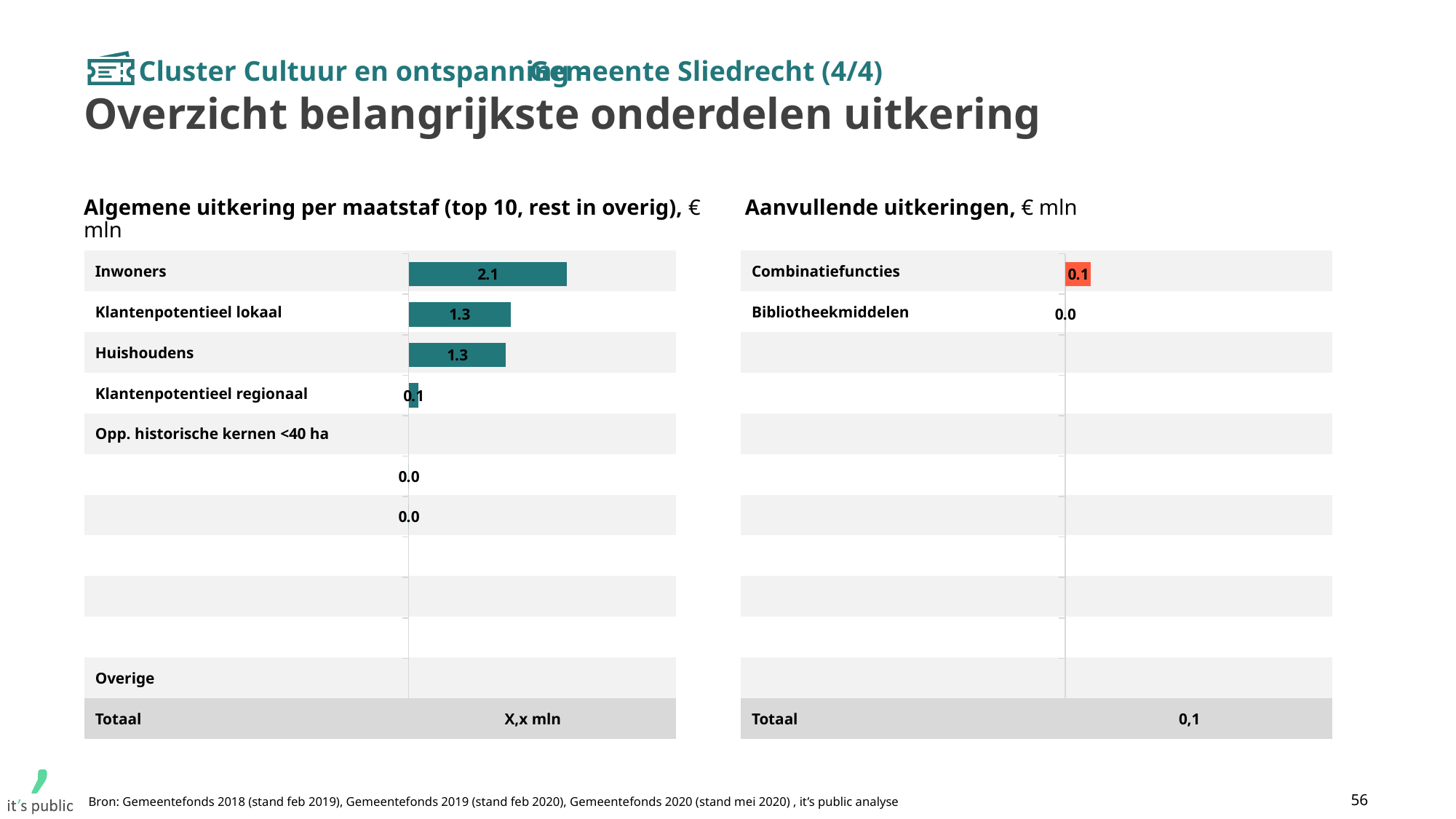
In the chart 'Algemene uitkering per maatstaf', what is the difference between the values for Inwoners and Klantenpotentieel lokaal? 0.8 In the chart 'Aanvullende uitkeringen', what is the value for Bibliotheekmiddelen? 0.0 In the chart 'Algemene uitkering per maatstaf', what is the value for Klantenpotentieel lokaal? 1.3 In the chart 'Algemene uitkering per maatstaf', what is the value for Klantenpotentieel regionaal? 0.1 In the chart 'Aanvullende uitkeringen', which category has the highest value? Combinatiefuncties In the chart 'Algemene uitkering per maatstaf', which is larger: the value for Inwoners or the value for Huishoudens? Inwoners In the chart 'Algemene uitkering per maatstaf', which category has the highest value? Inwoners In the chart 'Aanvullende uitkeringen', what is the Totaal shown at the bottom? 0,1 In the chart 'Aanvullende uitkeringen', what is the value for Combinatiefuncties? 0.1 In the chart 'Algemene uitkering per maatstaf', what is the value for Inwoners? 2.1 What kind of chart is the chart 'Algemene uitkering per maatstaf'? Bar chart In the chart 'Algemene uitkering per maatstaf', what is the value for Huishoudens? 1.3